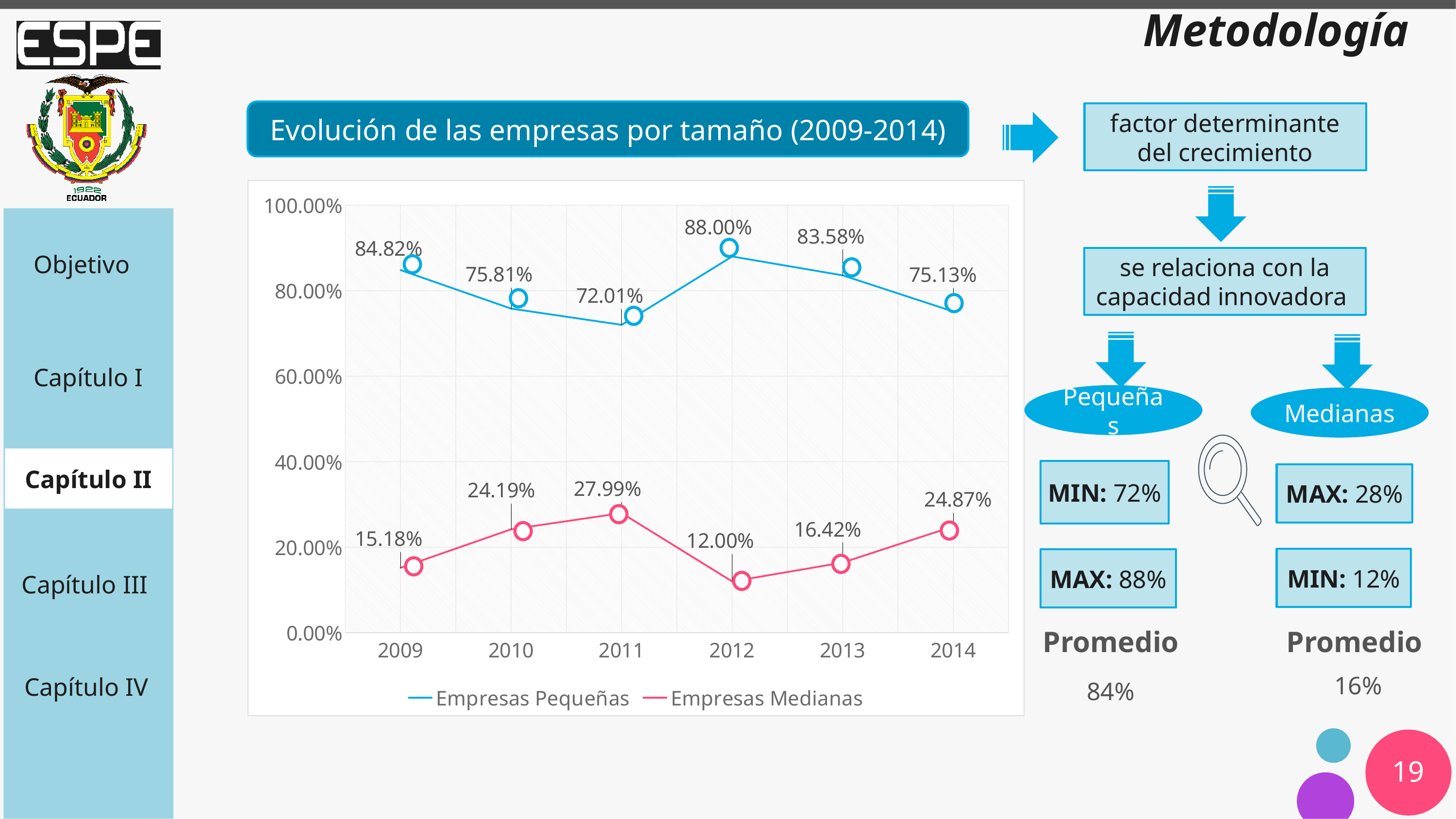
What is the value for Empresas Pequeñas in 2012? 88.00% What is the value for Empresas Medianas in 2009? 15.18% What type of chart is shown on the slide? Line chart In which year is the value for Empresas Pequeñas lowest? 2011 In which year is the value for Empresas Medianas highest? 2011 What is the value for Empresas Medianas in 2011? 27.99% Which is larger for Empresas Medianas: the value in 2010 or the value in 2013? 2010 How many years are plotted on the x axis of the chart? 6 In which year is the value for Empresas Medianas lowest? 2012 How many series does the chart legend list? 2 What is the difference between the Empresas Pequeñas value in 2012 and in 2011? 15.99% Does the value for Empresas Pequeñas rise or fall from 2012 to 2014? Fall